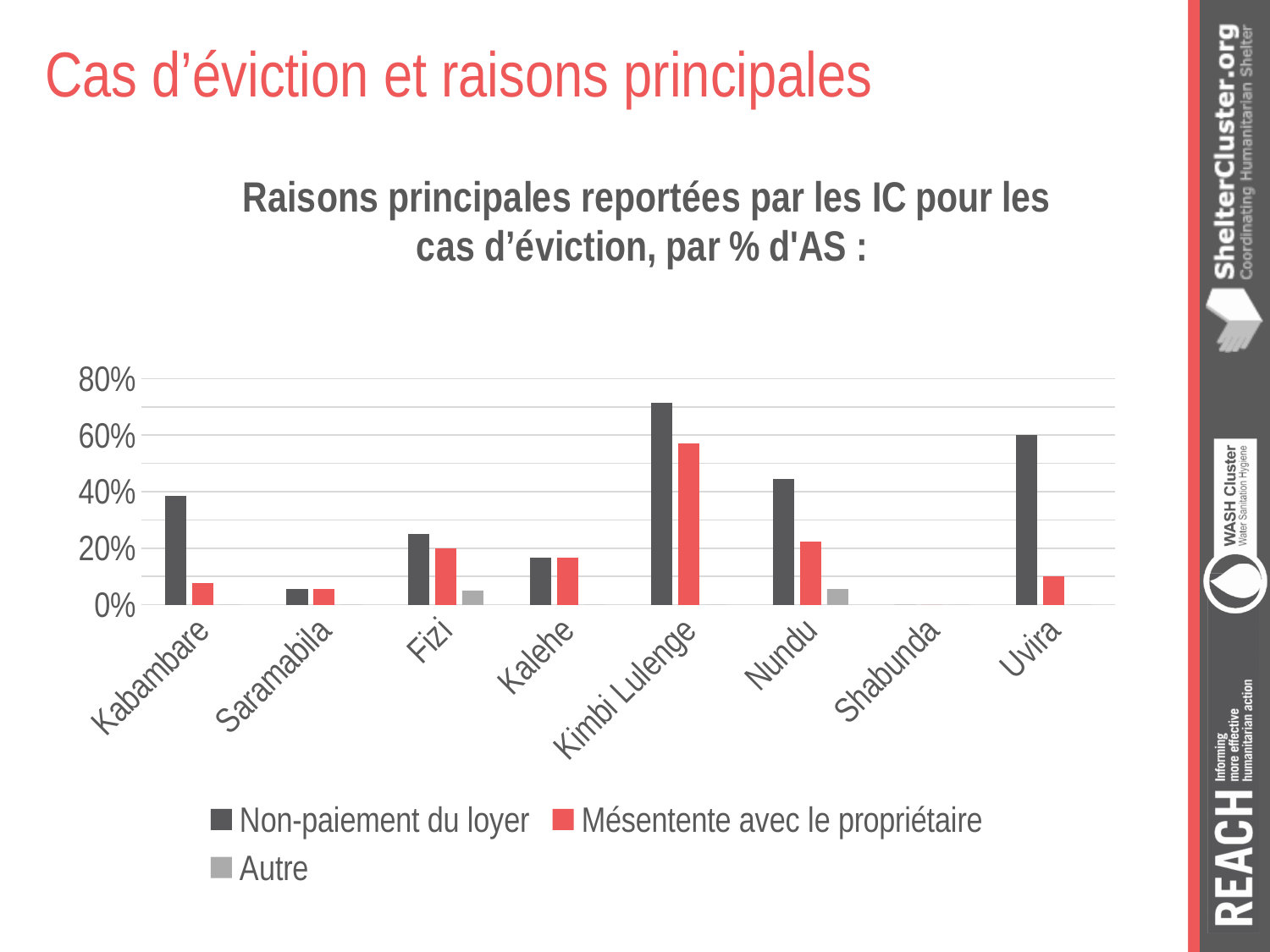
What kind of chart is shown on the slide? bar chart How many series does the legend list? 3 Is the value for Mésentente avec le propriétaire at Uvira greater or less than 20%? less What colour are the bars for Mésentente avec le propriétaire? red Which category has the highest value for Mésentente avec le propriétaire? Kimbi Lulenge Is the value for Mésentente avec le propriétaire at Kimbi Lulenge greater or less than 40%? greater Is the value for Non-paiement du loyer at Kimbi Lulenge greater or less than 60%? greater Which is larger for Non-paiement du loyer: Nundu or Uvira? Uvira How many categories are shown on the x axis? 8 Which category has the highest value for Non-paiement du loyer? Kimbi Lulenge At Kabambare, which is larger: Non-paiement du loyer or Mésentente avec le propriétaire? Non-paiement du loyer